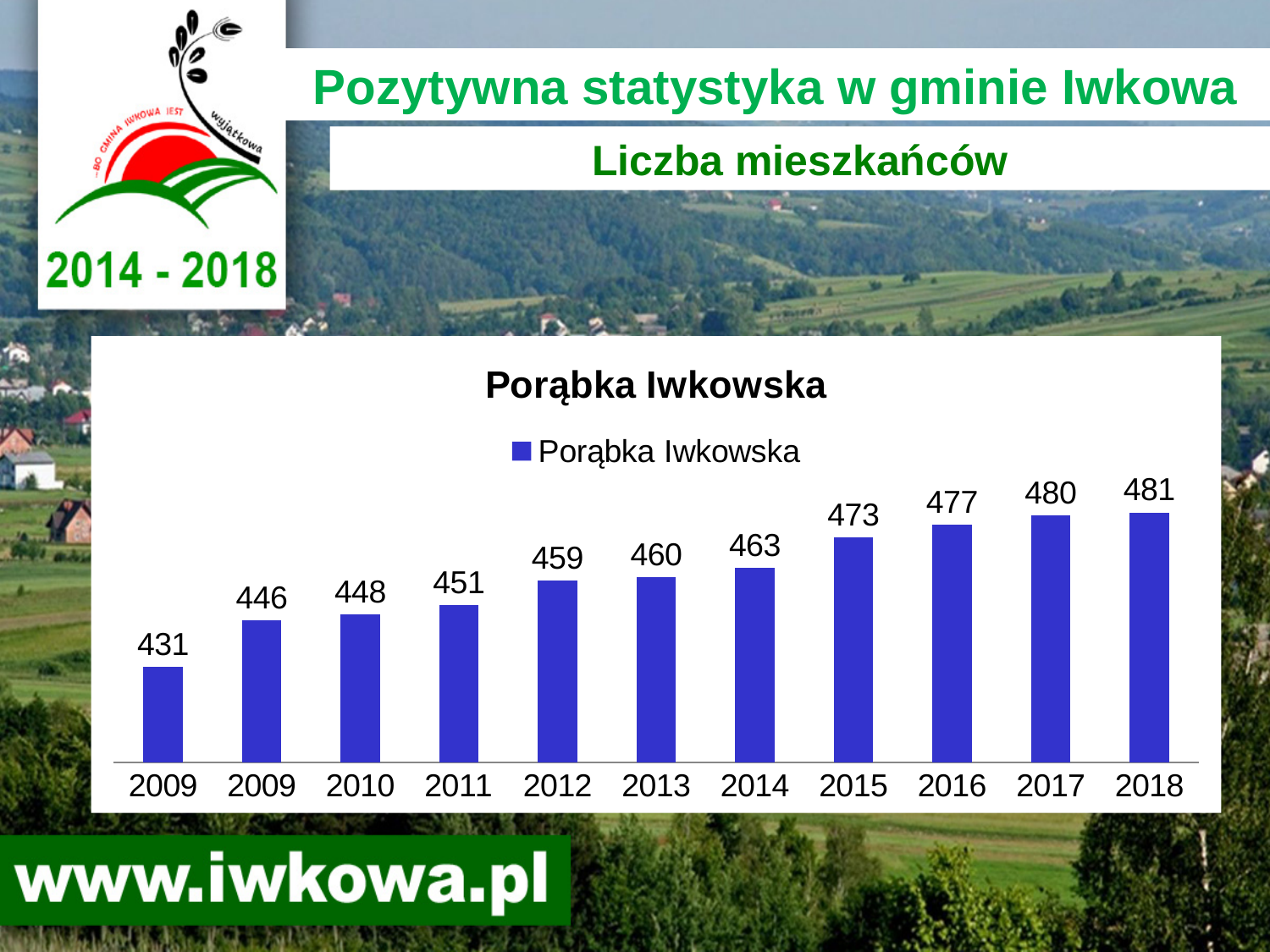
What is the difference between the values for 2015 and 2014 in the Porąbka Iwkowska chart? 10 Do the values in the Porąbka Iwkowska chart rise or fall from left to right along the x axis? Rise What is the value of the lowest bar in the Porąbka Iwkowska chart? 431 What is the value for 2015 in the Porąbka Iwkowska chart? 473 How many bars are shown in the Porąbka Iwkowska chart? 11 What is the value for 2018 in the Porąbka Iwkowska chart? 481 What is the value for 2012 in the Porąbka Iwkowska chart? 459 What kind of chart is shown on the slide? Bar chart What is the difference between the values for 2018 and 2011 in the Porąbka Iwkowska chart? 30 Which is larger in the Porąbka Iwkowska chart, the value for 2013 or the value for 2016? 2016 Which year has the highest value in the Porąbka Iwkowska chart? 2018 What is the value for 2010 in the Porąbka Iwkowska chart? 448